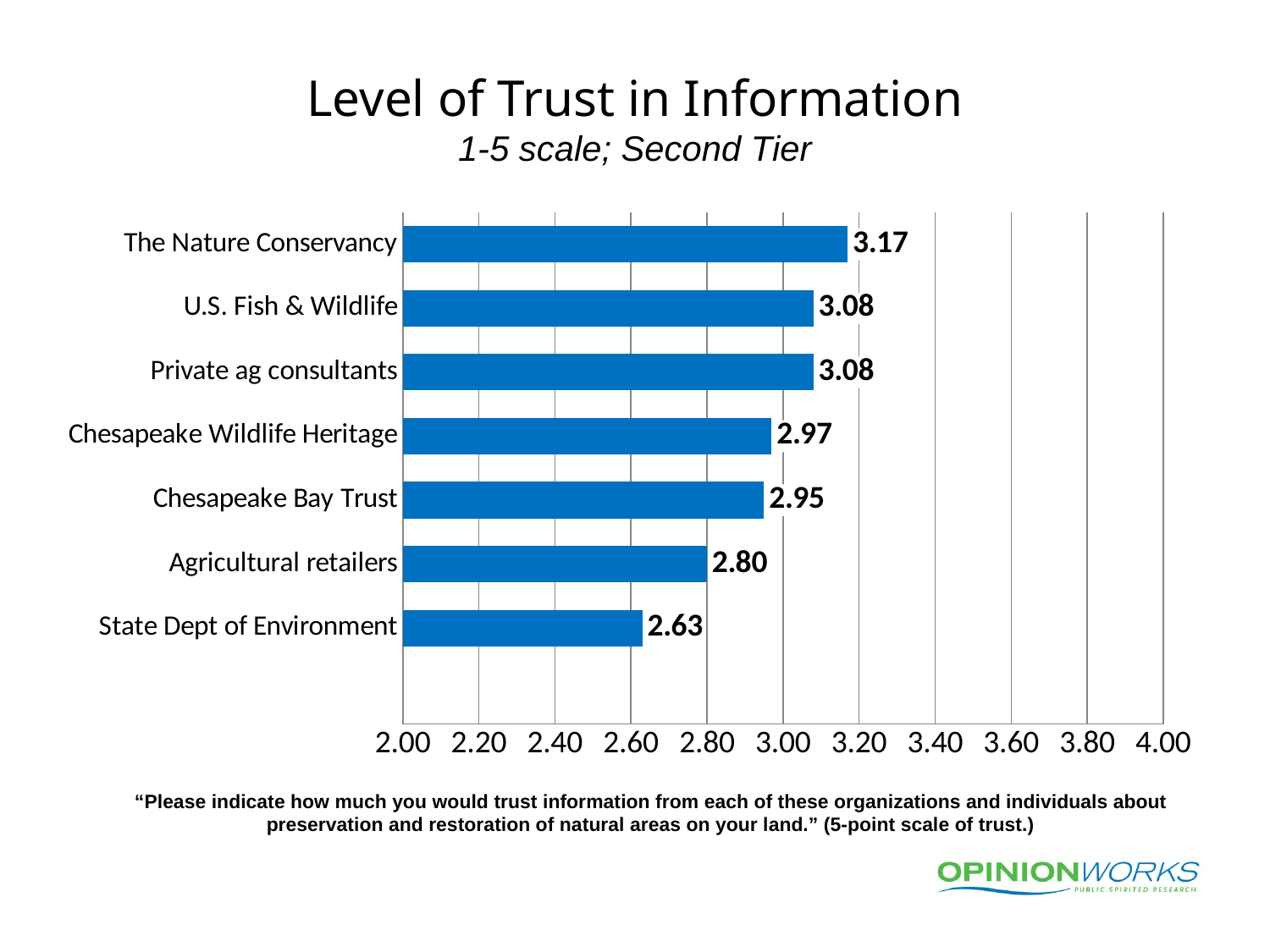
Which organization has the highest level of trust? The Nature Conservancy What is the level of trust value for The Nature Conservancy? 3.17 What is the level of trust value for Chesapeake Bay Trust? 2.95 What kind of chart is shown on the slide? Bar chart What is the level of trust value for Agricultural retailers? 2.80 What is the level of trust value for State Dept of Environment? 2.63 What is the title of the chart? Level of Trust in Information What is the difference between the values for The Nature Conservancy and State Dept of Environment? 0.54 What is the difference between the values for Chesapeake Wildlife Heritage and Agricultural retailers? 0.17 Which organization has the lowest level of trust? State Dept of Environment How many organizations are shown in the chart? 7 Which has a higher value, Chesapeake Wildlife Heritage or Agricultural retailers? Chesapeake Wildlife Heritage